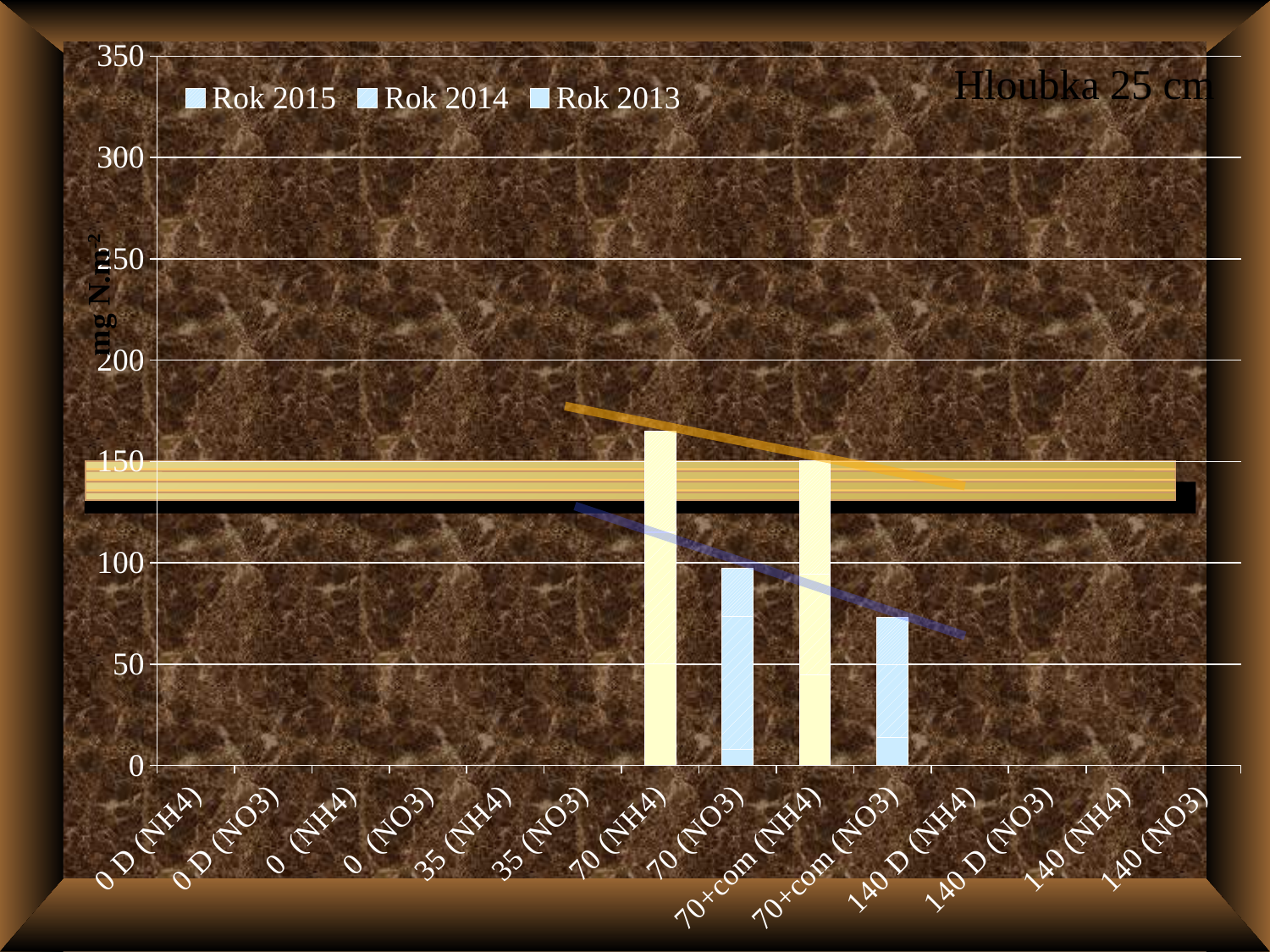
How many series does the legend list? 3 Which bar is taller, 70+com (NH4) or 70+com (NO3)? 70+com (NH4) What kind of chart is shown on the slide? bar chart Is the value of the bar for 70+com (NH4) greater or less than 100? greater How many categories are shown along the x axis? 14 Is the value of the bar for 70 (NO3) greater or less than 50? greater What is the title shown in the top right of the chart? Hloubka 25 cm Which category has the tallest bar shown on the chart? 70 (NH4) Is the value of the bar for 70 (NH4) greater or less than 150? greater Which bar is taller, 70 (NH4) or 70 (NO3)? 70 (NH4) Which series are listed in the legend? Rok 2015, Rok 2014, Rok 2013